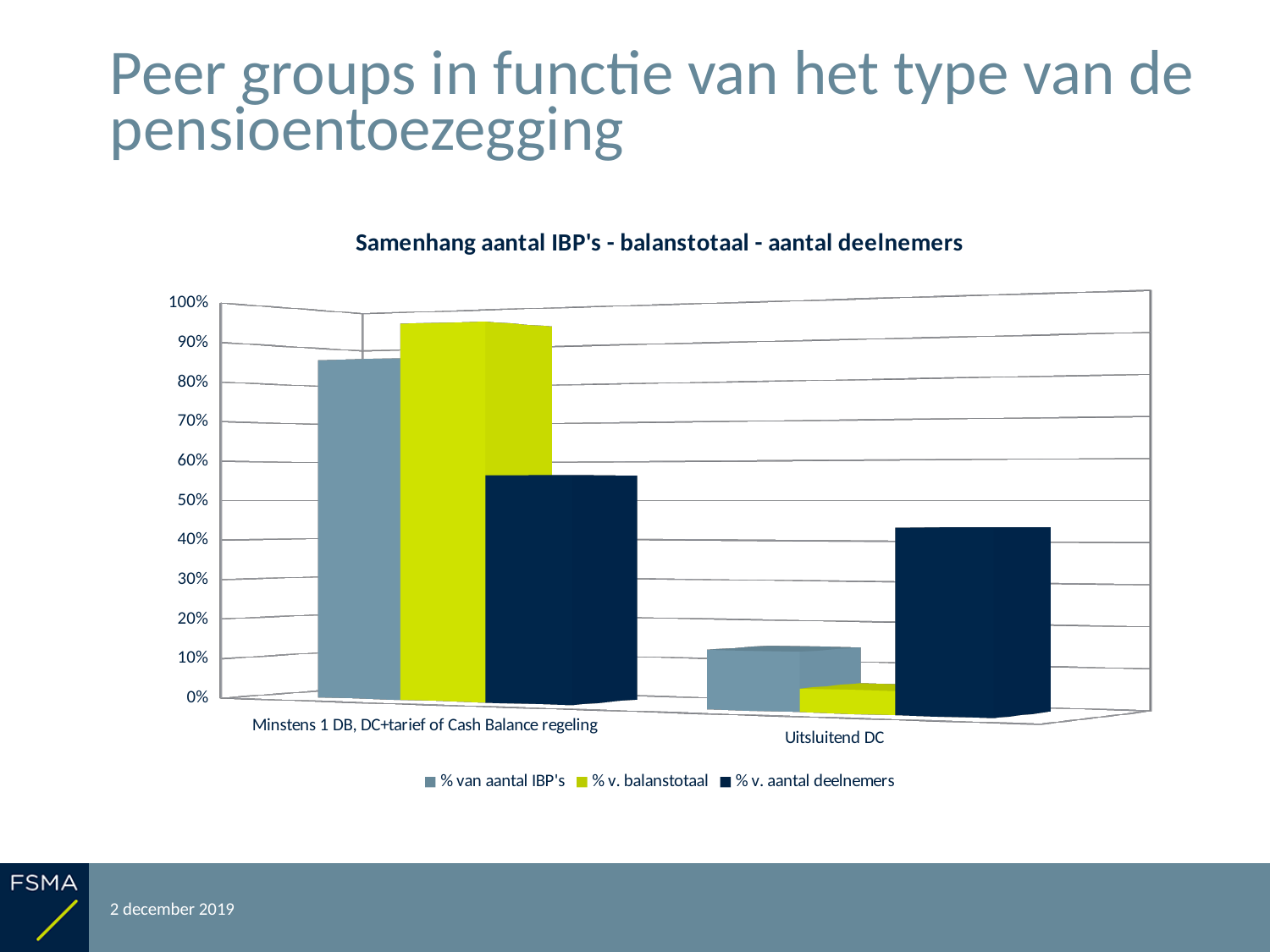
Is the value of '% v. balanstotaal' for 'Uitsluitend DC' greater or less than 10%? less Is the value of '% van aantal IBP's' for 'Minstens 1 DB, DC+tarief of Cash Balance regeling' greater or less than 70%? greater For the series '% v. aantal deelnemers', which category has the larger value: 'Minstens 1 DB, DC+tarief of Cash Balance regeling' or 'Uitsluitend DC'? Minstens 1 DB, DC+tarief of Cash Balance regeling Which series is shown in yellow-green in the chart? % v. balanstotaal Which series has the highest value for 'Minstens 1 DB, DC+tarief of Cash Balance regeling'? % v. balanstotaal Which series has the lowest value for 'Uitsluitend DC'? % v. balanstotaal Is the value of '% v. aantal deelnemers' for 'Uitsluitend DC' greater or less than 30%? greater How many categories are shown on the x axis of the chart? 2 What kind of chart is shown on the slide? bar chart How many series does the legend list? 3 What is the title of the chart? Samenhang aantal IBP's - balanstotaal - aantal deelnemers